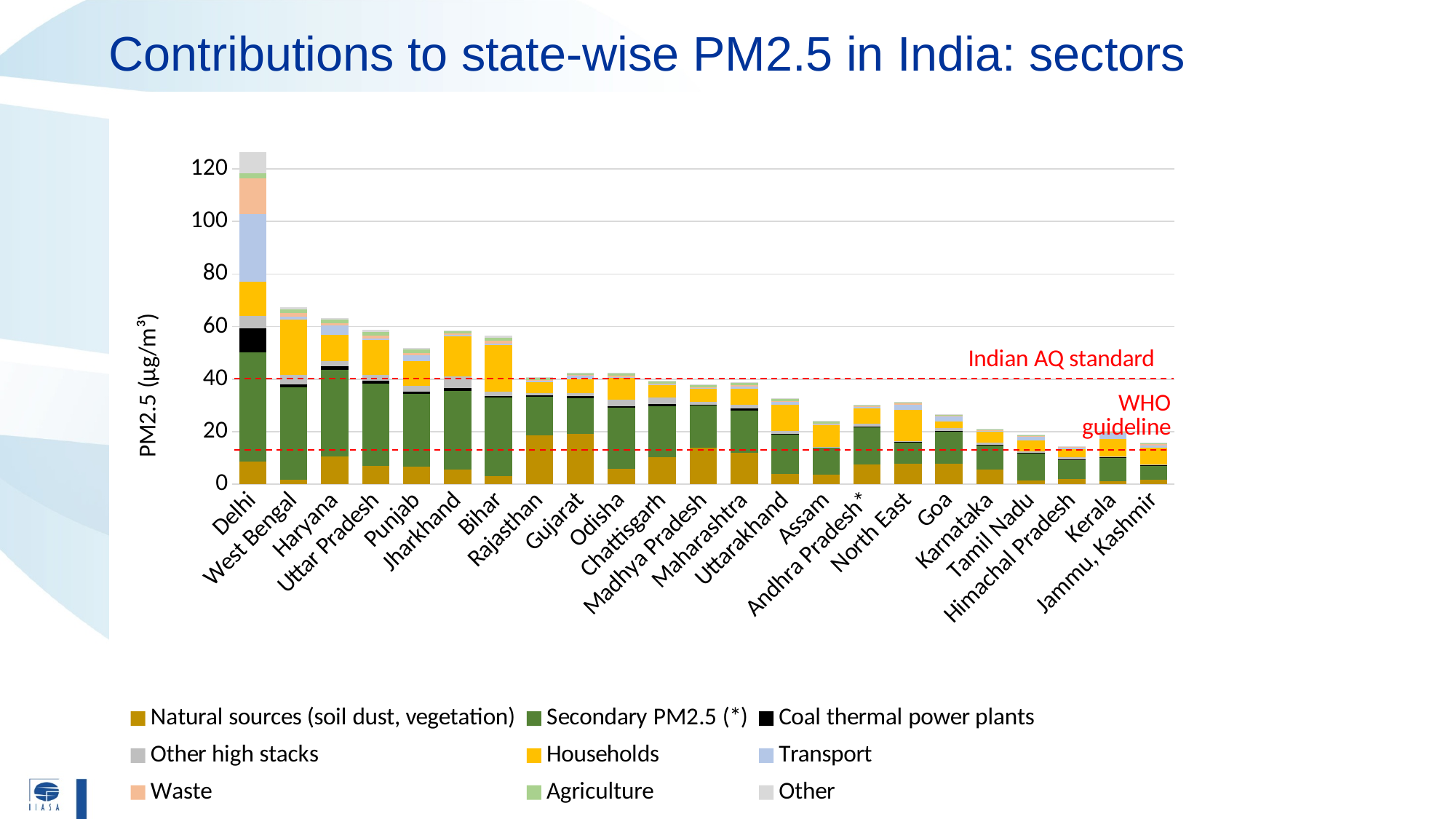
What is the label of the y axis? PM2.5 (µg/m³) What are the two dashed red reference lines labelled? Indian AQ standard and WHO guideline Which has a larger total PM2.5 value, Haryana or Goa? Haryana How many states or regions are plotted along the x axis? 23 How many series does the legend list? 9 Is the total value for Assam greater or less than 40? less Which state has the highest total PM2.5 value? Delhi Is the total value for West Bengal greater or less than 60? greater Do the total bar heights generally rise or fall moving from left to right along the x axis? fall What kind of chart is shown on the slide? Stacked bar chart Is the total value for Delhi greater or less than 120? greater